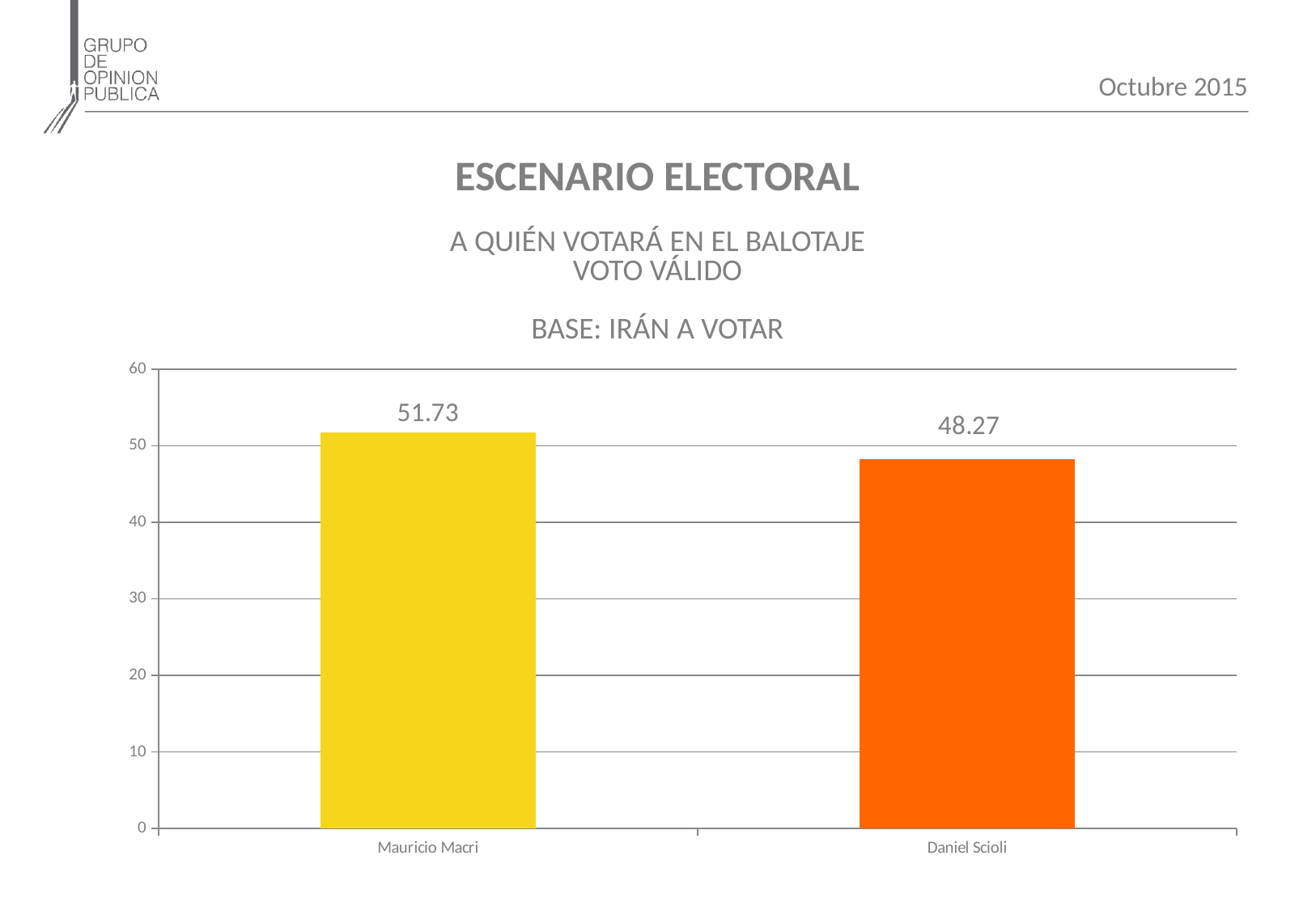
How many candidates are shown in the chart? 2 Which candidate has the lowest value? Daniel Scioli Who has the larger value, Mauricio Macri or Daniel Scioli? Mauricio Macri What is the difference between the values for Mauricio Macri and Daniel Scioli? 3.46 Is the value for Daniel Scioli greater or less than 50? less Is the value for Mauricio Macri greater or less than 50? greater What is the value shown for Mauricio Macri? 51.73 What is the value shown for Daniel Scioli? 48.27 Which candidate has the highest value? Mauricio Macri What is the total of the two values shown in the chart? 100 What colour is the bar for Daniel Scioli? Orange What kind of chart is shown on the slide? Bar chart